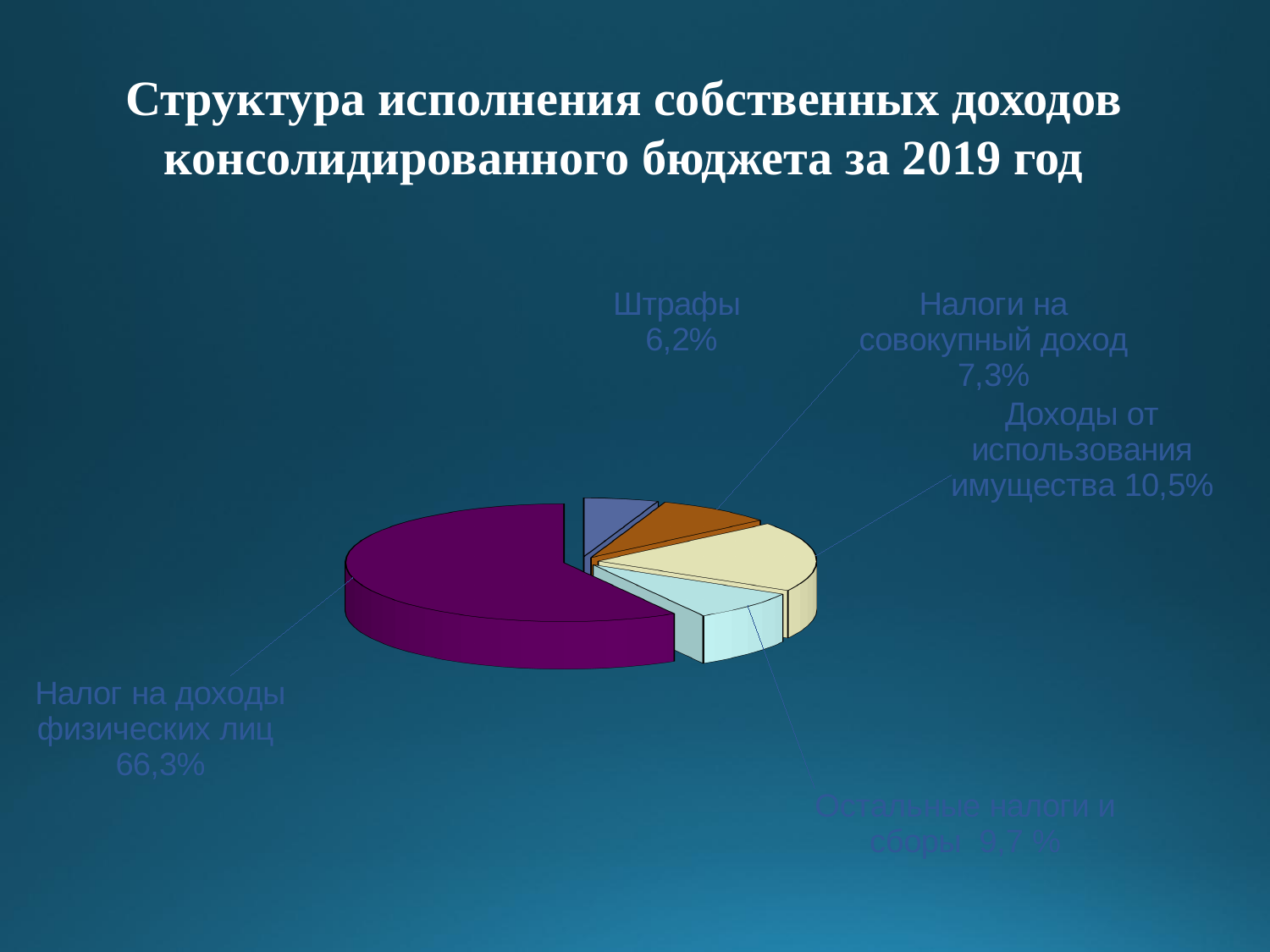
What share of the pie does Налог на доходы физических лиц have? 66,3% How many slices does the pie chart have? 5 What is the difference in percentage points between Доходы от использования имущества and Штрафы? 4,3 What is the value shown for Доходы от использования имущества? 10,5% What is the value shown for Штрафы? 6,2% What is the value shown for Налоги на совокупный доход? 7,3% Which is larger, Доходы от использования имущества or Налоги на совокупный доход? Доходы от использования имущества What kind of chart is shown on the slide? pie chart What is the title of the slide? Структура исполнения собственных доходов консолидированного бюджета за 2019 год Which category has the smallest slice of the pie? Штрафы Which category has the largest slice of the pie? Налог на доходы физических лиц What is the difference in percentage points between Налоги на совокупный доход and Штрафы? 1,1